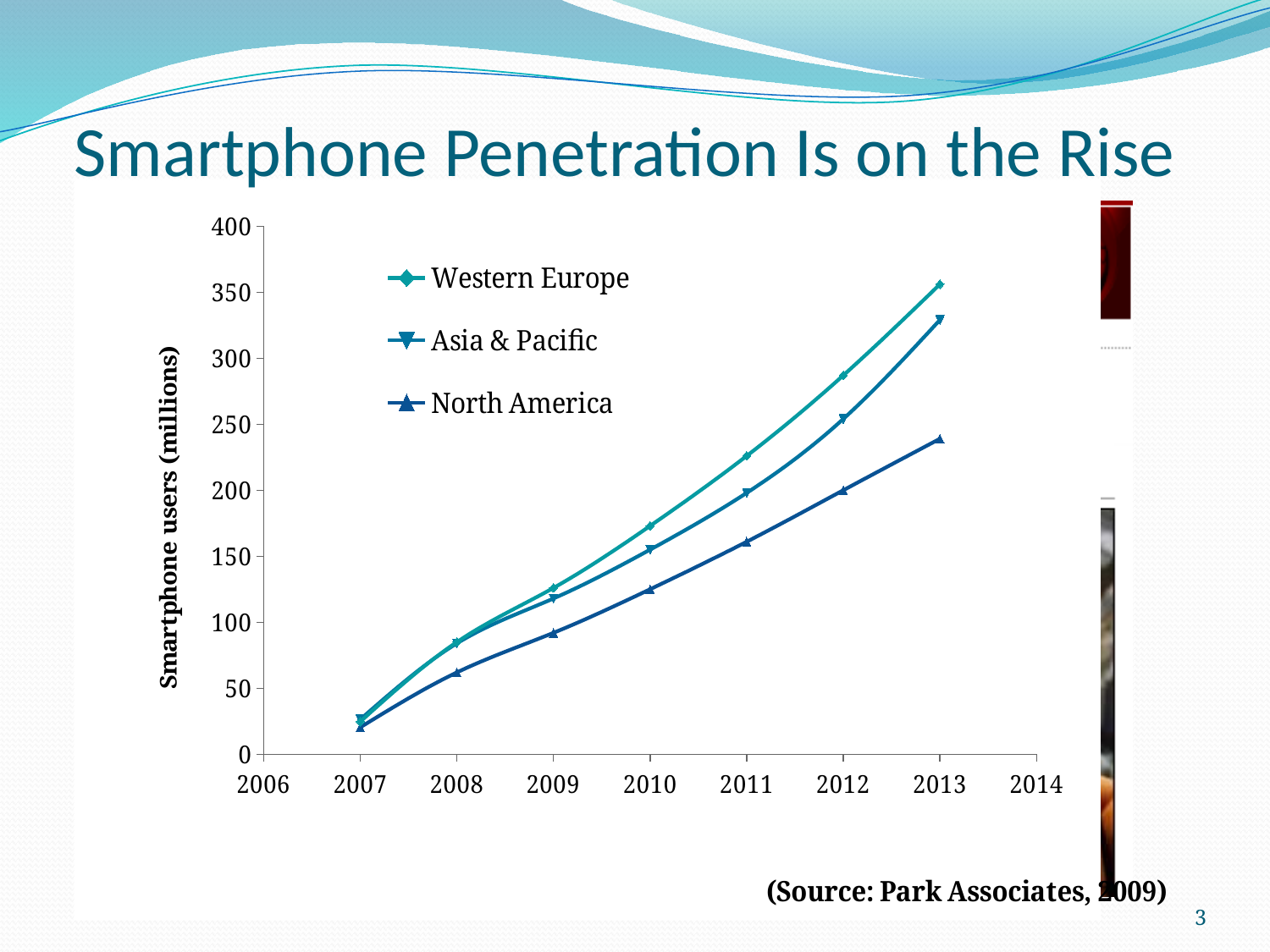
In 2010, which is larger: the value for Western Europe or the value for Asia & Pacific? Western Europe Which series has the lowest value in 2013? North America What kind of chart is shown on the slide? line chart What is the label on the vertical axis of the chart? Smartphone users (millions) Which series has the highest value in 2013? Western Europe Is the value for North America in 2007 greater or less than 50? less Is the value for Western Europe in 2012 greater or less than 300? less Is the value for North America in 2013 greater or less than 250? less Do the values for North America rise or fall from 2007 to 2013? rise How many data points are plotted for the Western Europe series? 7 How many series does the legend list? 3